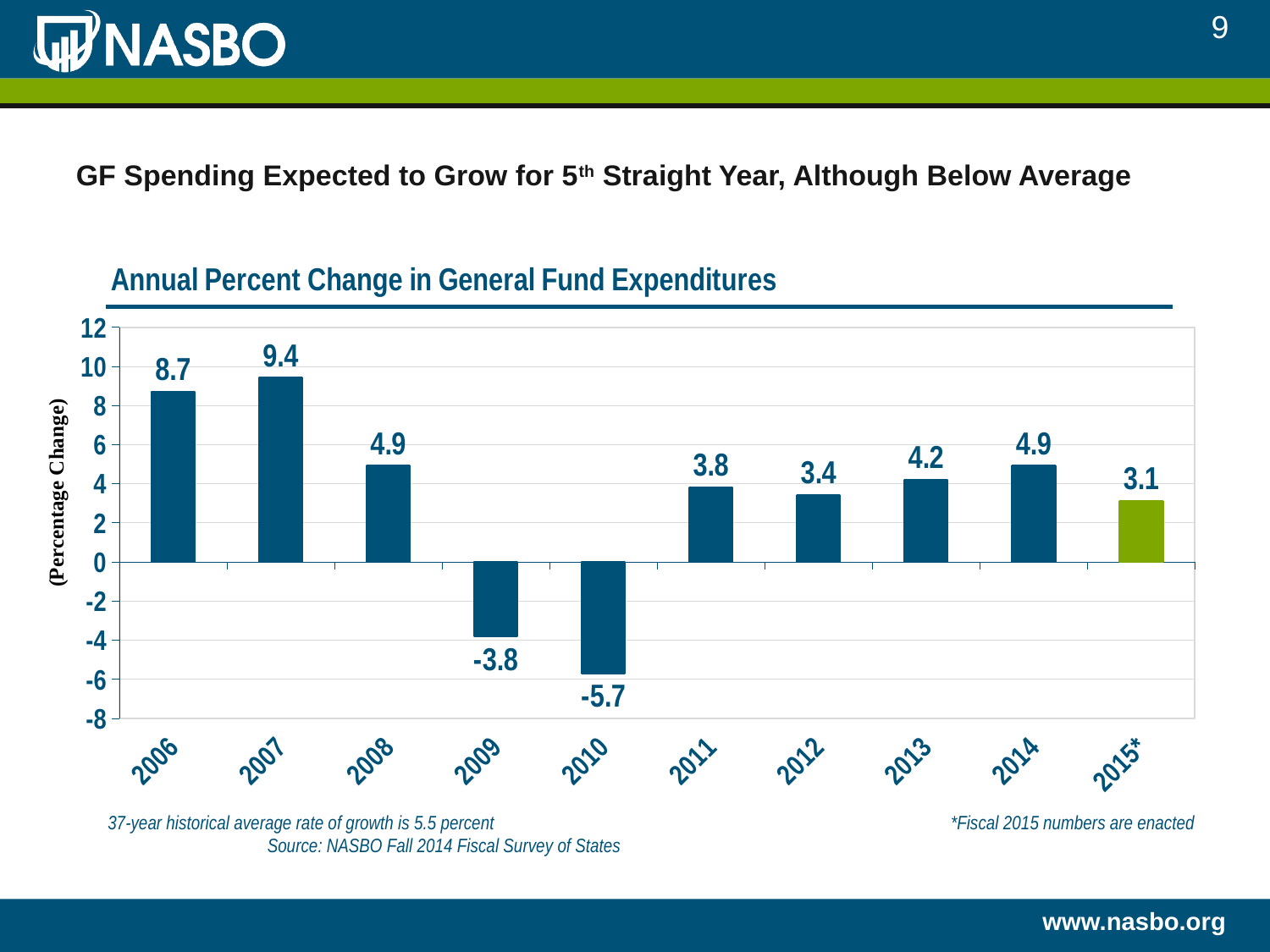
What is the value shown for 2010? -5.7 How many years are shown on the x axis? 10 What is the value shown for 2015*? 3.1 What is the difference between the values for 2006 and 2008? 3.8 Which year has the highest annual percent change? 2007 Which year's bar is shown in green rather than blue? 2015* What is the title of the chart? Annual Percent Change in General Fund Expenditures What kind of chart is shown on the slide? Bar chart Which is larger, the value for 2011 or the value for 2012? 2011 What is the annual percent change in general fund expenditures for 2007? 9.4 Which year has the lowest annual percent change? 2010